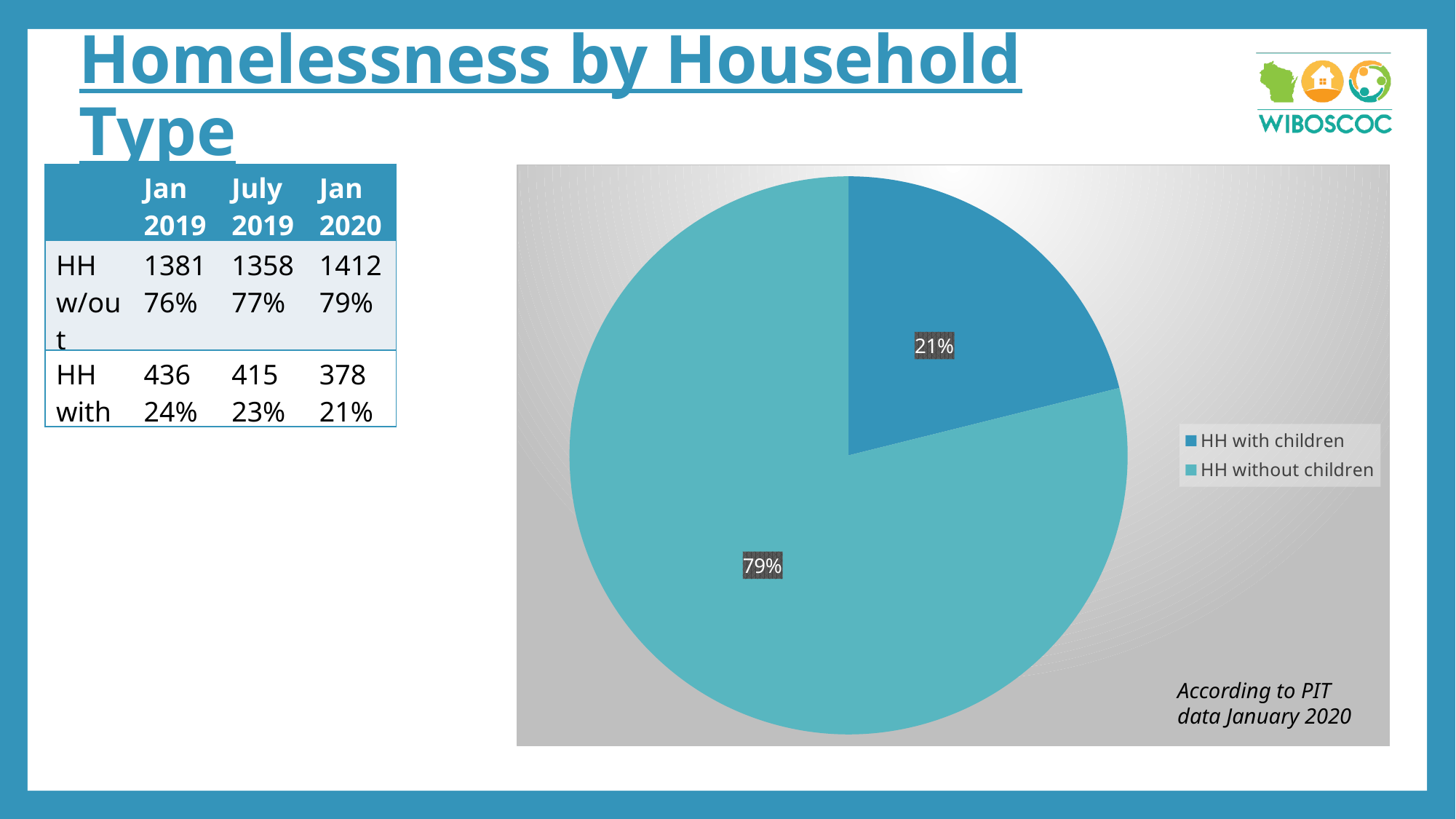
According to the note on the chart, what data source and date does the pie chart use? PIT data January 2020 Which slice of the pie chart is the smallest? HH with children What is the difference in percentage points between the HH without children slice and the HH with children slice? 58% Which legend entry is shown in the darker blue colour? HH with children What share of the pie chart is labelled for HH without children? 79% What kind of chart is shown on the slide? pie chart What share of the pie chart is labelled for HH with children? 21% Which is larger in the pie chart, HH with children or HH without children? HH without children How many entries does the pie chart's legend list? 2 Is the share for HH without children greater or less than 50%? greater How many slices does the pie chart have? 2 Which slice of the pie chart is the largest? HH without children